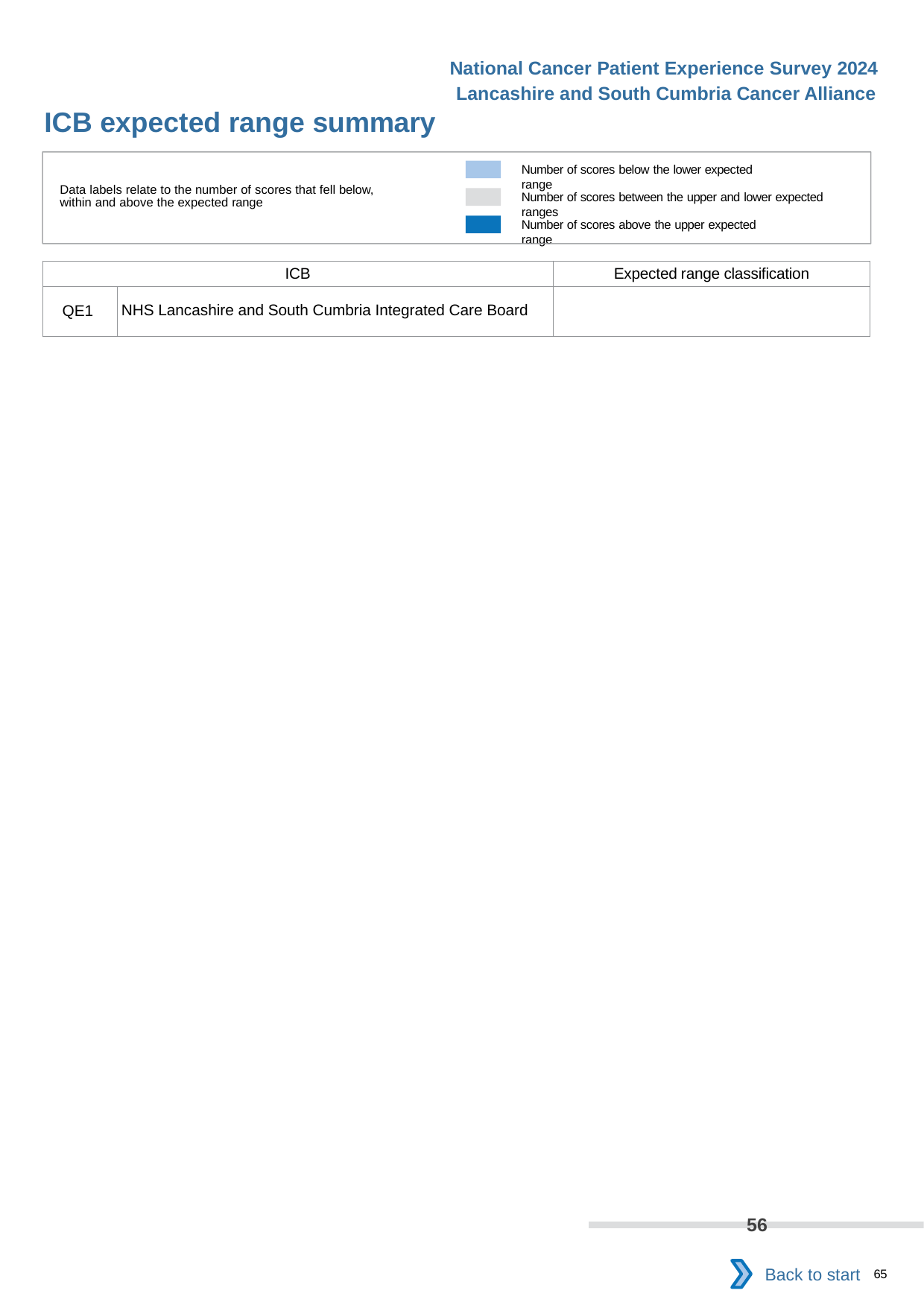
What value is printed on the grey bar near the bottom of the slide? 56 According to the legend, what does the dark blue colour represent? Number of scores above the upper expected range How many colour categories does the legend at the top of the slide list? 3 According to the legend, what does the grey colour represent? Number of scores between the upper and lower expected ranges Is the value printed on the grey bar near the bottom of the slide greater or less than 50? greater